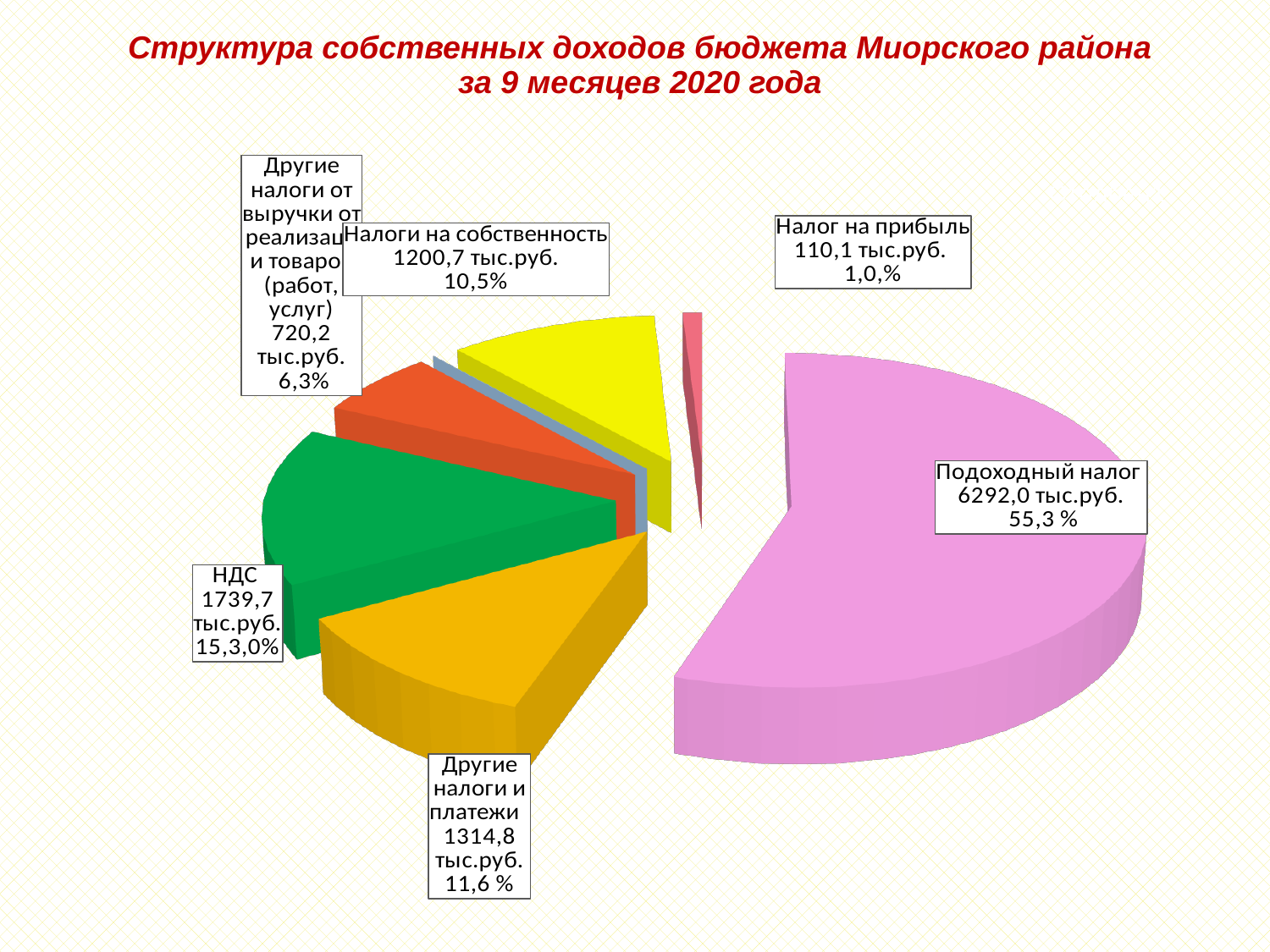
What is the value for Налог на прибыль? 110,1 тыс.руб. Which is larger, НДС or Другие налоги и платежи? НДС What is the difference between Подоходный налог and НДС? 4552,3 тыс.руб. Which labelled category has the smallest value? Налог на прибыль What is the value for Подоходный налог? 6292,0 тыс.руб. What is the value for Другие налоги и платежи? 1314,8 тыс.руб. Which category has the largest value? Подоходный налог What share of the pie does Подоходный налог represent? 55,3 % What is the value for Налоги на собственность? 1200,7 тыс.руб. What is the difference between Другие налоги и платежи and Налоги на собственность? 114,1 тыс.руб. What is the value for НДС? 1739,7 тыс.руб. What kind of chart is shown on the slide? Pie chart